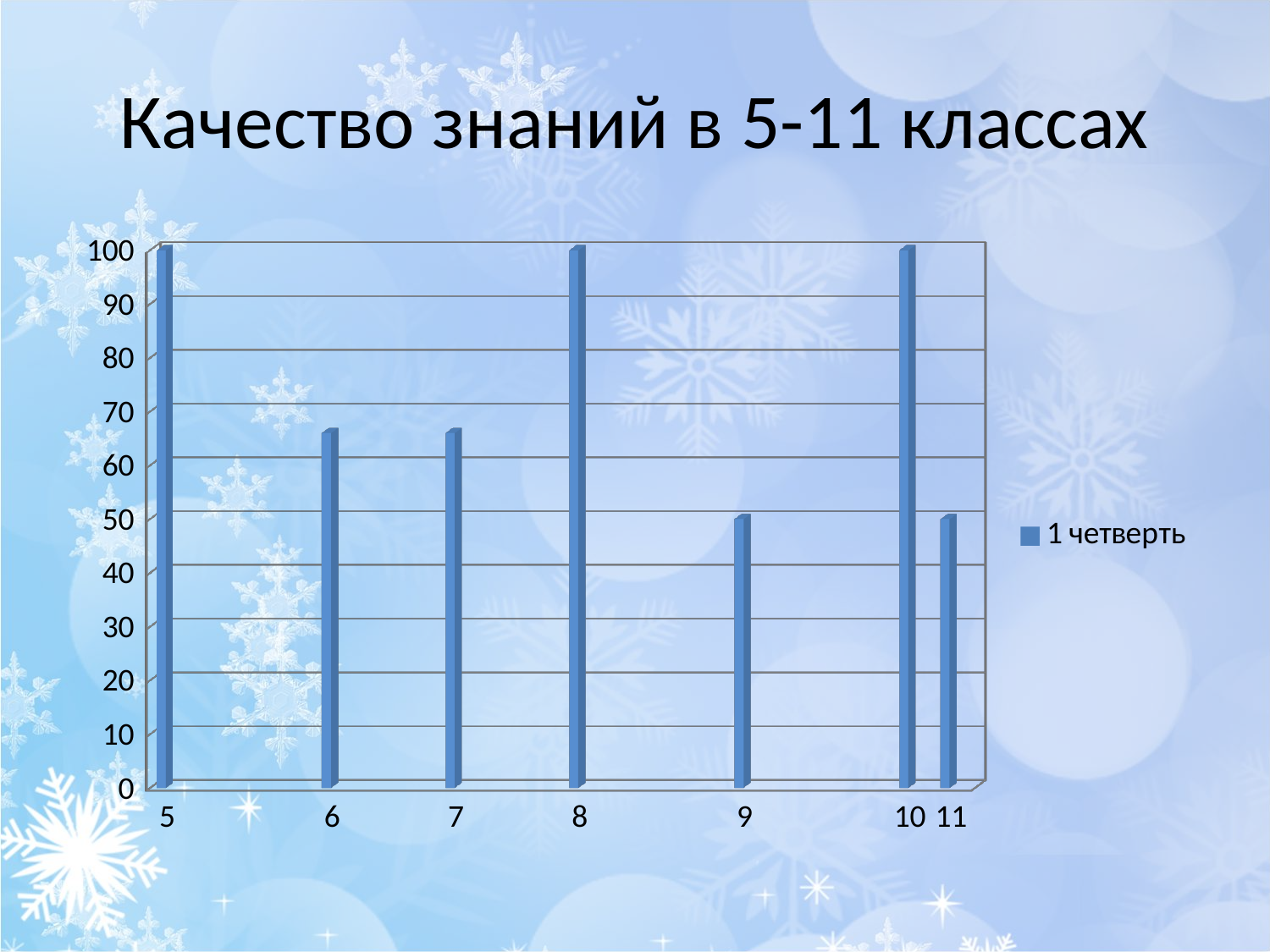
What is the value for class 10 in the chart? 100 What is the value for class 9 in the chart? 50 How many categories (classes) are shown on the x axis of the chart? 7 What series name is shown in the chart legend? 1 четверть What is the value for class 11 in the chart? 50 What kind of chart is shown on the slide? bar chart How many series does the chart legend list? 1 What is the value for class 5 in the chart? 100 Which has the larger value, class 8 or class 9? 8 Is the value for class 7 greater or less than 70? less Is the value for class 6 greater or less than 60? greater What is the difference between the values for class 5 and class 9? 50